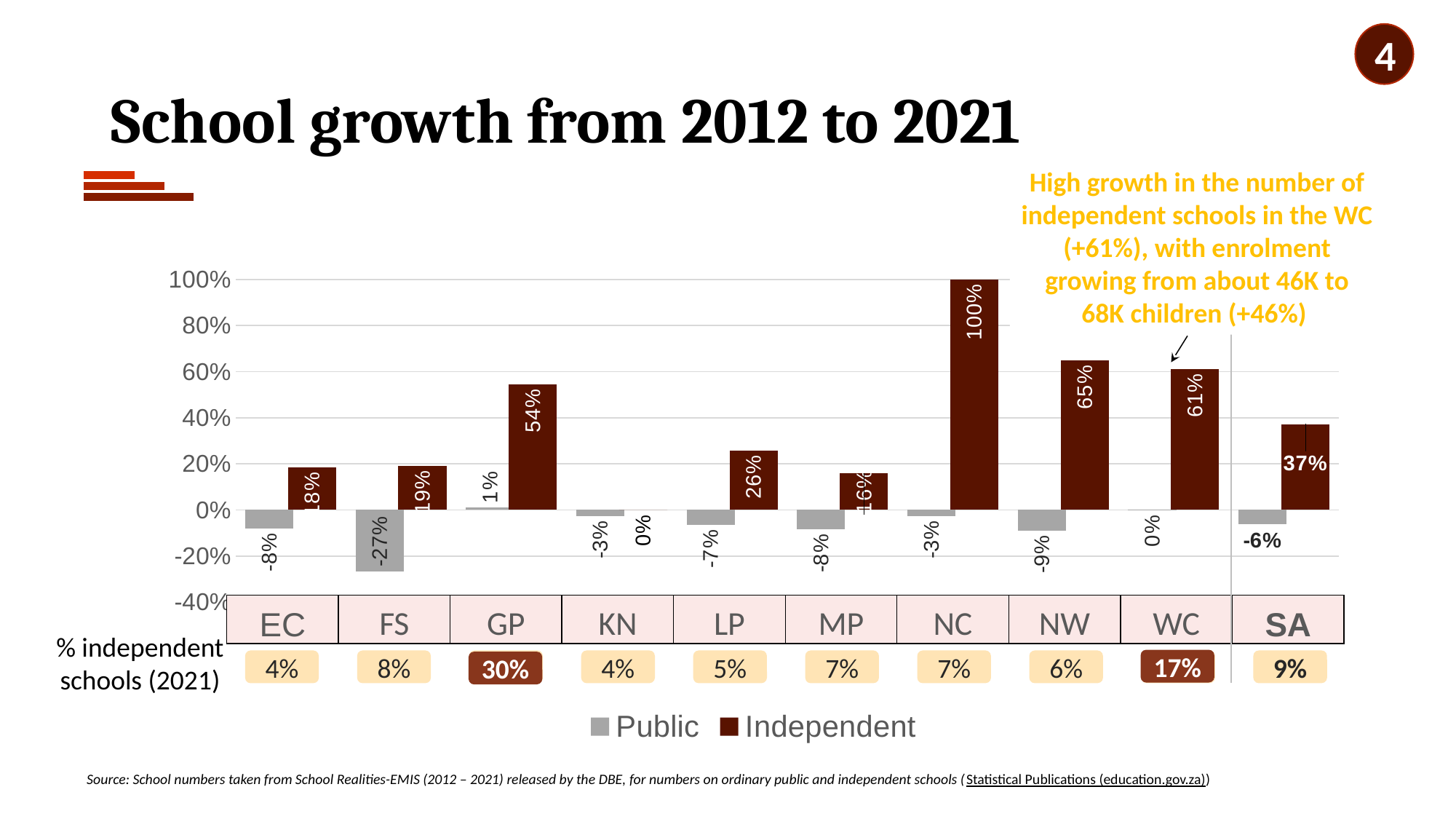
What is the difference between the Independent values for NW and WC? 4% What type of chart is shown on the slide? bar chart Is the Independent value for SA greater or less than 20%? greater Which category has the highest Independent value? NC How many series does the legend list? 2 What is the Public value for SA? -6% Which category has the lowest Public value? FS What is the Independent value for NC? 100% What is the Public value for FS? -27% Which is larger, the Independent value for GP or the Independent value for LP? GP What is the Independent value for WC? 61% How many categories are shown on the x axis of the chart? 10